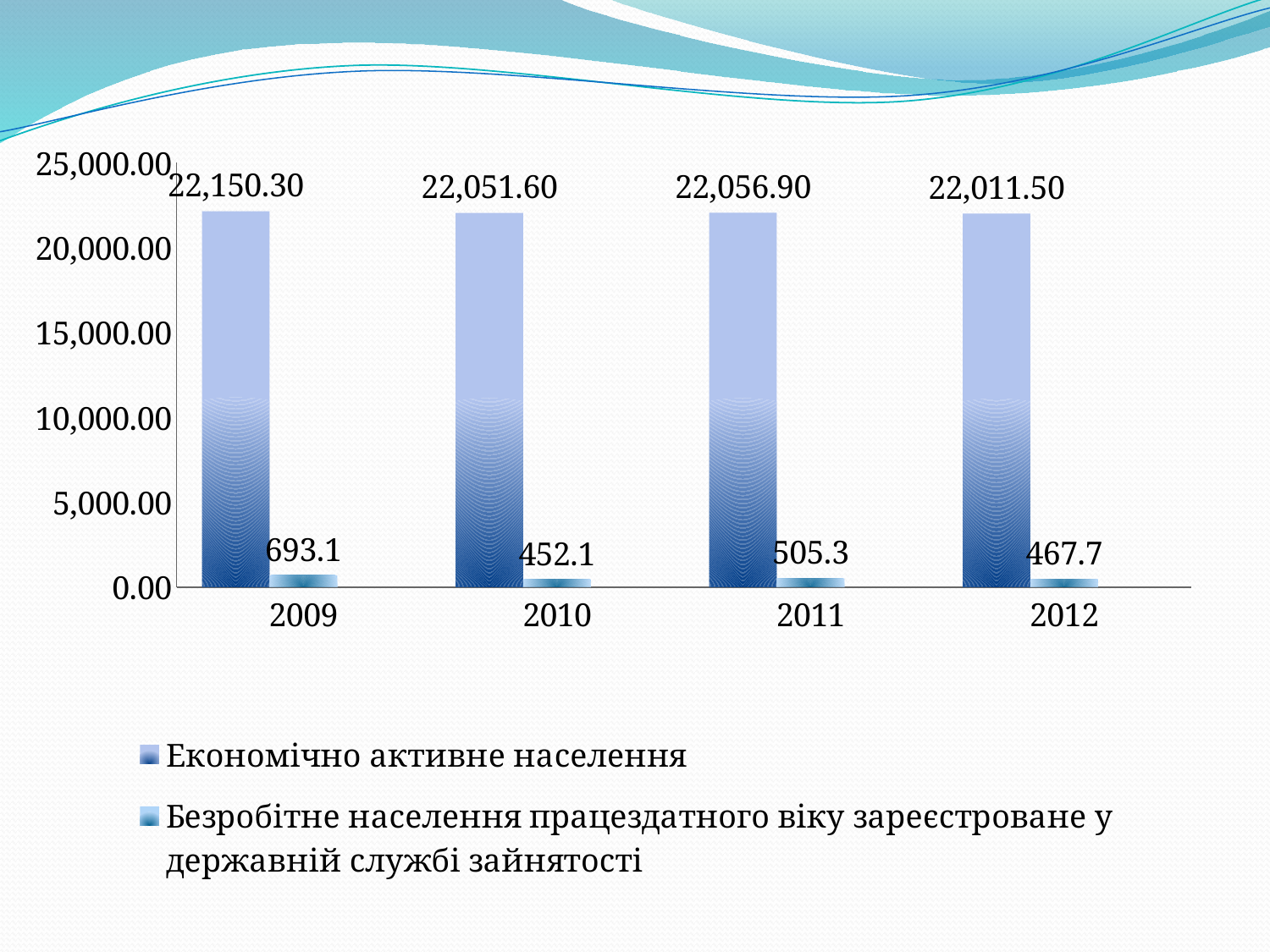
What is the difference between the Безробітне населення values for 2009 and 2010? 241.0 In which year is Економічно активне населення lowest? 2012 How many series does the legend list? 2 Which is larger: Безробітне населення in 2011 or in 2012? 2011 In which year is Безробітне населення працездатного віку зареєстроване у державній службі зайнятості lowest? 2010 What is the value for Економічно активне населення in 2009? 22,150.30 What is the value for Економічно активне населення in 2012? 22,011.50 In which year is Безробітне населення працездатного віку зареєстроване у державній службі зайнятості highest? 2009 What kind of chart is shown on the slide? Bar chart How many years are shown on the x axis? 4 What is the value for Безробітне населення працездатного віку зареєстроване у державній службі зайнятості in 2011? 505.3 What is the difference between the Економічно активне населення values for 2009 and 2012? 138.80